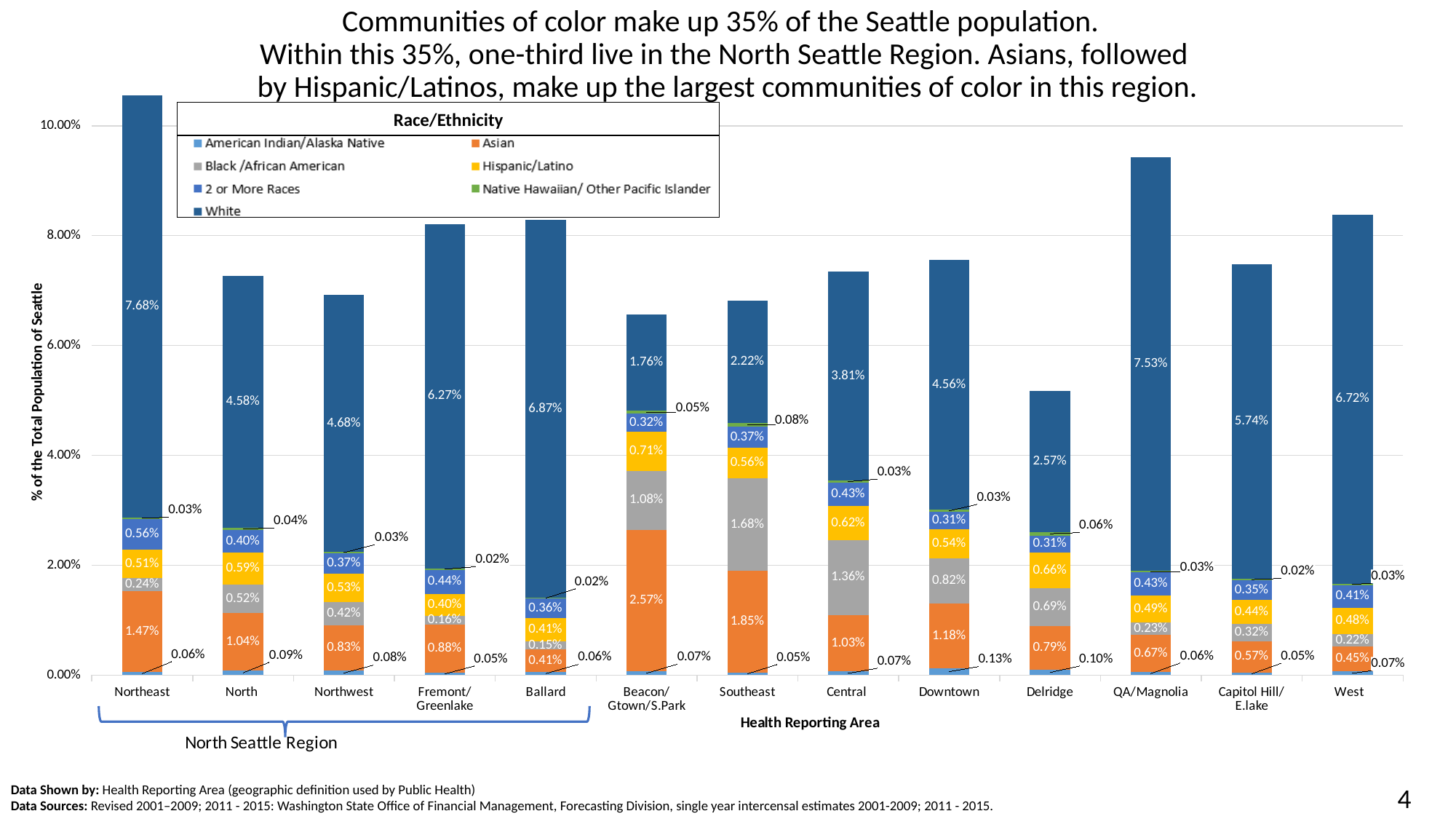
What is the total of the stacked bar for Northeast? 10.55% How many race/ethnicity series does the legend list? 7 What is the American Indian/Alaska Native value for Downtown? 0.13% What is the difference between the White value for Northeast and the White value for QA/Magnolia? 0.15% Is the total of the stacked bar for Delridge greater or less than 6.00%? less Which Health Reporting Area has the highest Asian value? Beacon/Gtown/S.Park How many Health Reporting Areas are shown on the x axis? 13 What kind of chart is shown on the slide? Stacked bar chart Which Health Reporting Area has the lowest White value? Beacon/Gtown/S.Park Which has the larger Black/African American value, Southeast or Central? Southeast What is the Asian value for Beacon/Gtown/S.Park? 2.57% What is the White value for Northeast? 7.68%